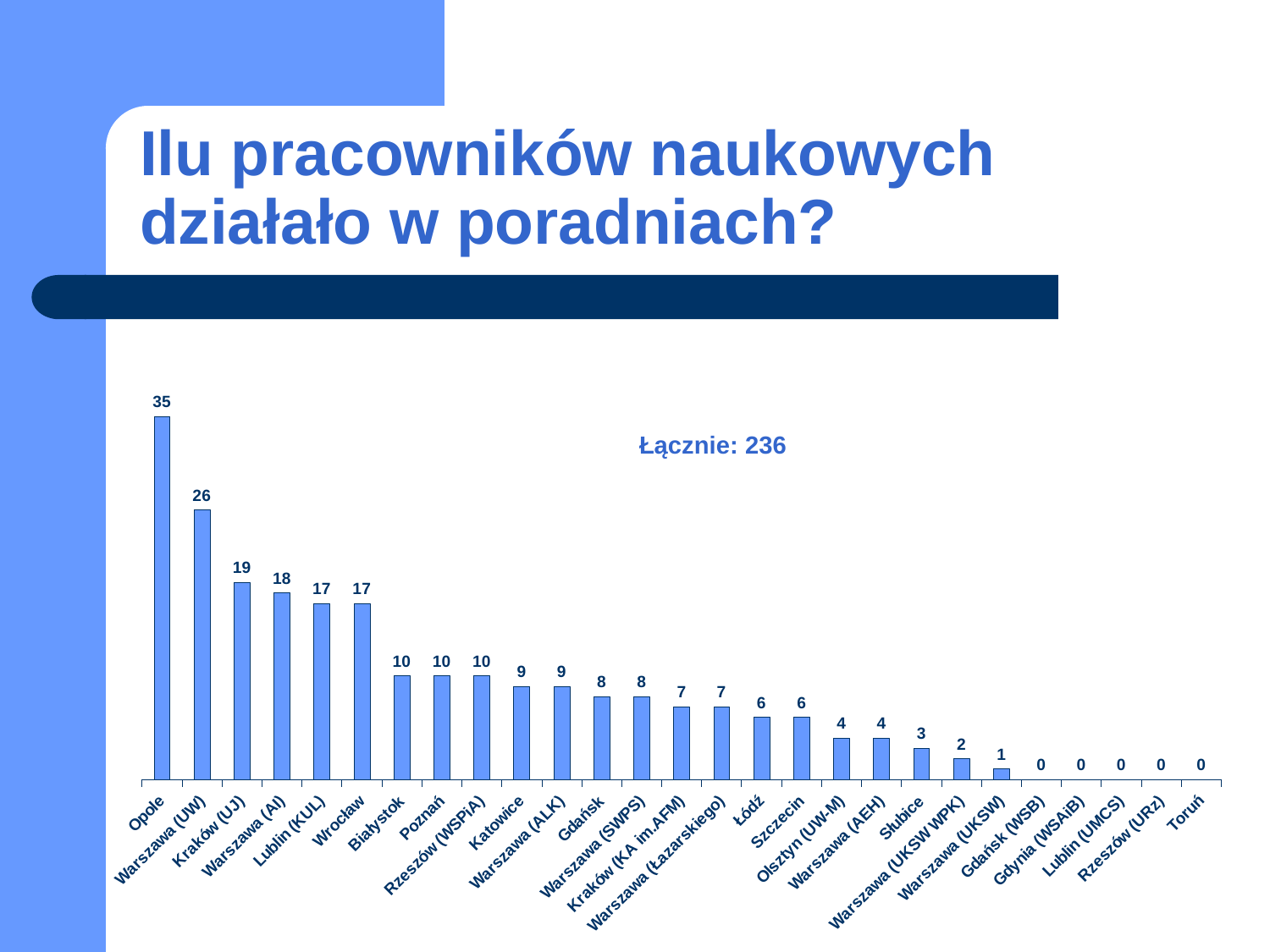
What is the difference between the values for Kraków (UJ) and Białystok? 9 What is the value for Opole? 35 What kind of chart is shown on the slide? Bar chart Which is larger, the value for Katowice or the value for Szczecin? Katowice What is the value for Warszawa (UW)? 26 How many categories are shown on the x axis? 27 What is the value for Słubice? 3 Do the values rise or fall from left to right along the x axis? Fall What is the value for Lublin (KUL)? 17 What total is stated in the text label on the chart ("Łącznie")? 236 Which category has the highest value? Opole What is the difference between the values for Opole and Warszawa (UW)? 9